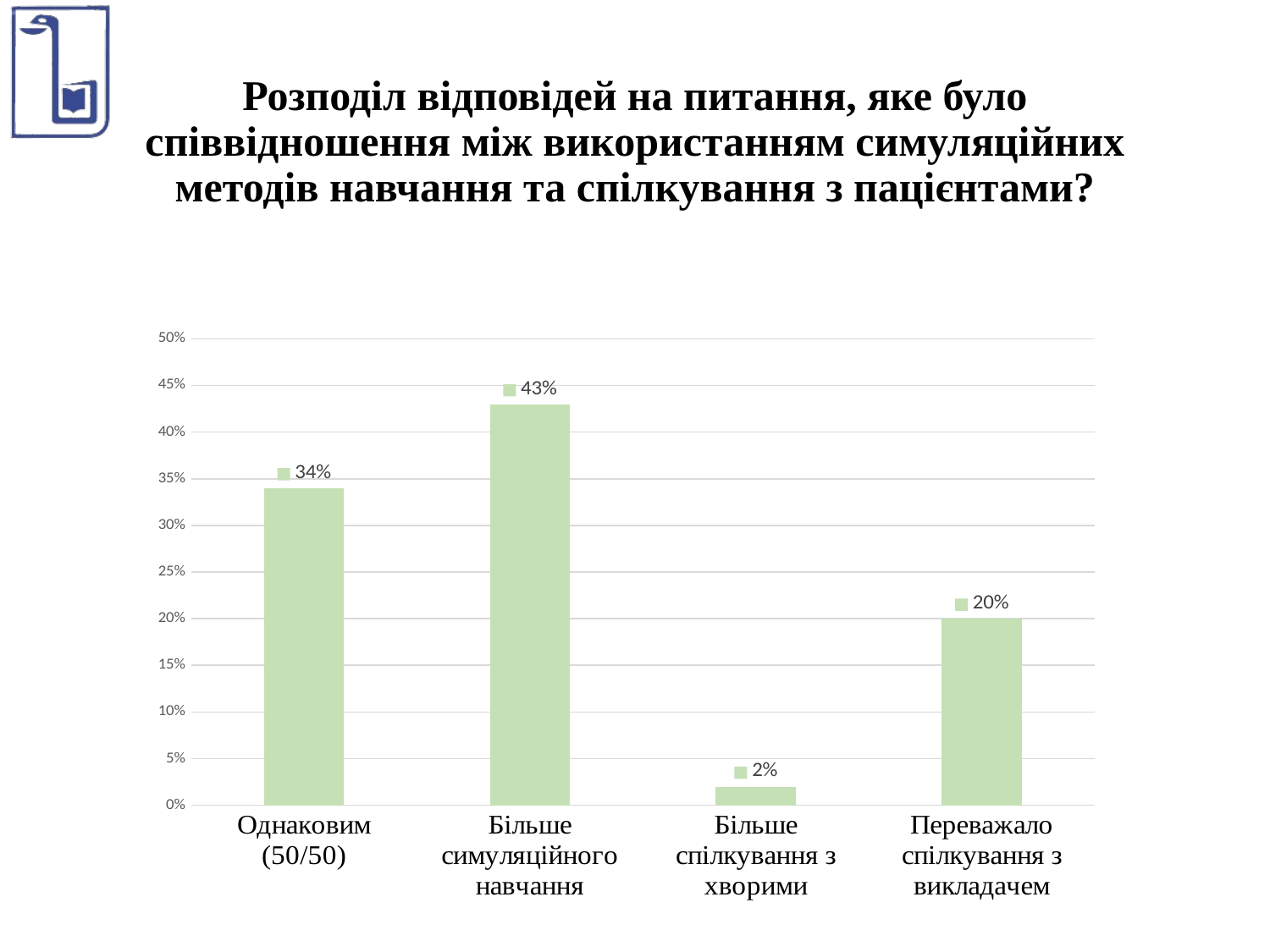
What is the value for "Однаковим (50/50)"? 34% What is the maximum value shown on the vertical axis? 50% Which is larger: the value for "Однаковим (50/50)" or for "Переважало спілкування з викладачем"? Однаковим (50/50) Is the value for "Переважало спілкування з викладачем" greater or less than 25%? less Which category has the lowest value? Більше спілкування з хворими How many categories are shown on the x axis? 4 What is the value for "Більше симуляційного навчання"? 43% What is the value for "Більше спілкування з хворими"? 2% Which category has the highest value? Більше симуляційного навчання What is the difference between the values for "Більше симуляційного навчання" and "Однаковим (50/50)"? 9% What kind of chart is shown on the slide? bar chart What is the value for "Переважало спілкування з викладачем"? 20%